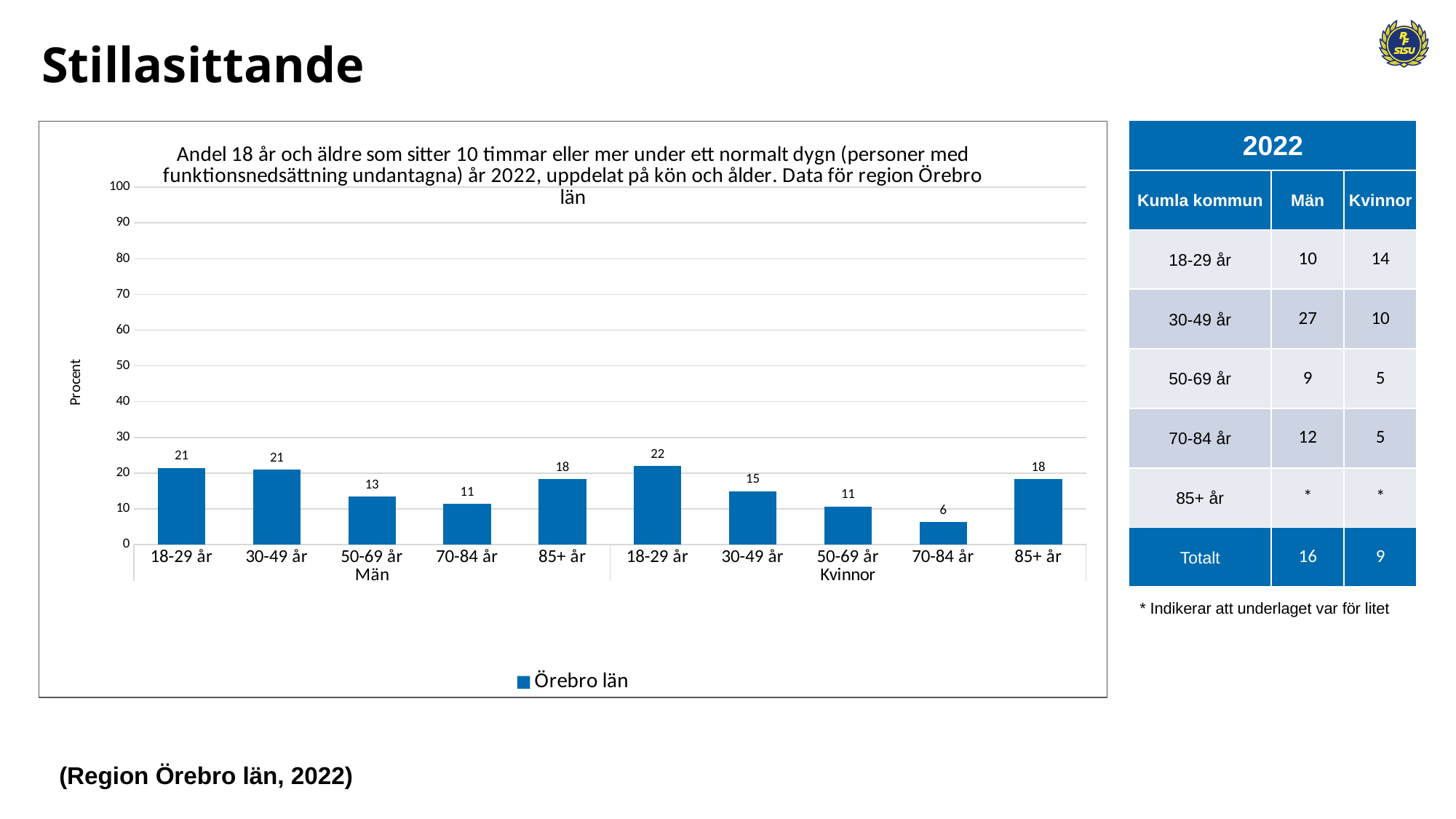
What is the value for women (Kvinnor) aged 70-84 år? 6 What is the value for men (Män) aged 50-69 år? 13 How many bars are plotted in the chart? 10 Which group has the lowest value in the chart? Kvinnor 70-84 år What is the difference between the values for men aged 30-49 år and women aged 30-49 år? 6 Which is larger: the value for men aged 70-84 år or women aged 70-84 år? Män 70-84 år What is the label of the y axis of the chart? Procent What kind of chart is shown on the slide? Bar chart How many series does the legend list? 1 Which group has the highest value in the chart? Kvinnor 18-29 år What is the value for women (Kvinnor) aged 18-29 år? 22 Is the value for men aged 85+ år greater or less than 10? greater